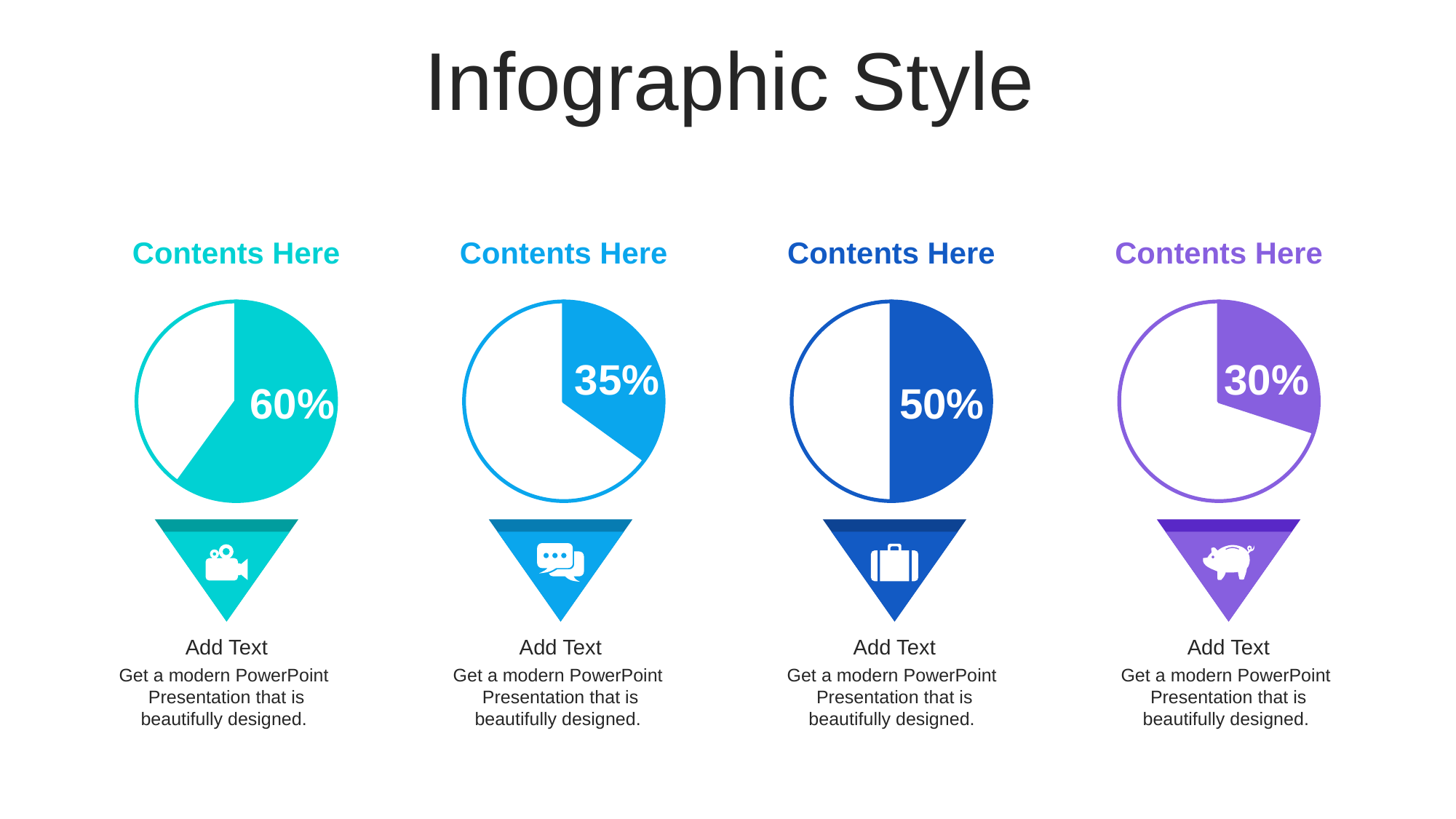
What value is shown on the rightmost pie chart (purple)? 30% What value is shown on the leftmost pie chart (teal)? 60% Which of the four pie charts shows the highest percentage? The leftmost (teal) chart, 60% Which of the four pie charts shows the lowest percentage? The rightmost (purple) chart, 30% What is the difference between the value on the third pie chart and the value on the second pie chart? 15% What kind of chart is used for each of the four figures on the slide? Pie chart What is the title shown above each of the four pie charts? Contents Here What is the difference between the value on the leftmost pie chart and the value on the rightmost pie chart? 30% Which is larger: the value on the second pie chart from the left or the value on the third pie chart from the left? The third chart (50%) What value is shown on the third pie chart from the left (dark blue)? 50% What value is shown on the second pie chart from the left (light blue)? 35% How many pie charts are on the slide? 4